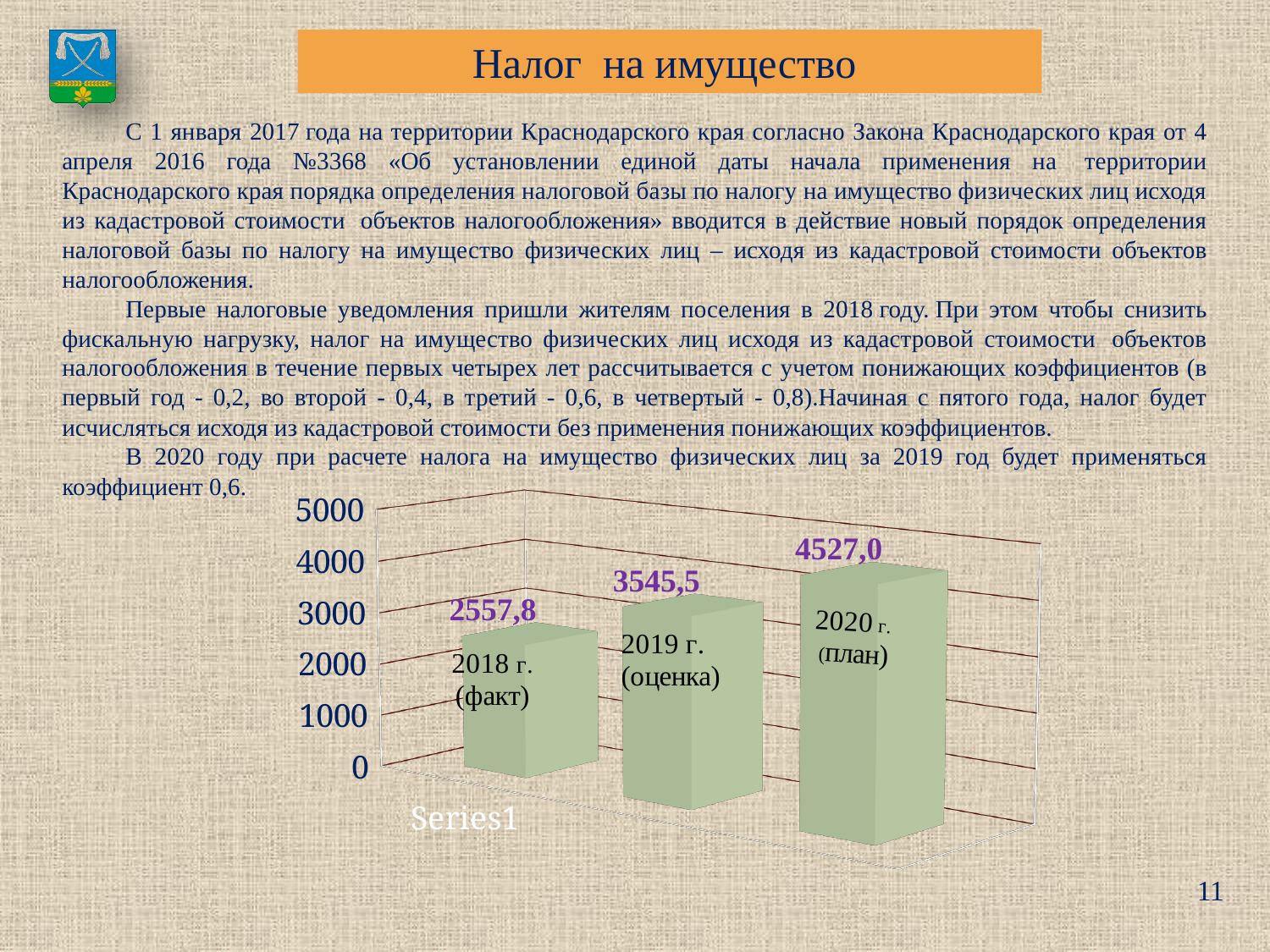
Which category has the highest value? 2020 г. (план) Which is larger, the value for 2019 г. (оценка) or the value for 2020 г. (план)? 2020 г. (план) What is the value for 2019 г. (оценка)? 3545,5 What kind of chart is shown on the slide? bar chart Do the values rise or fall from 2018 to 2020? rise Which category has the lowest value? 2018 г. (факт) What is the value for 2018 г. (факт)? 2557,8 What is the difference between the values for 2020 г. (план) and 2018 г. (факт)? 1969,2 What is the difference between the values for 2019 г. (оценка) and 2018 г. (факт)? 987,7 What is the value for 2020 г. (план)? 4527,0 Is the value for 2018 г. (факт) greater or less than 3000? less How many bars are shown in the chart? 3